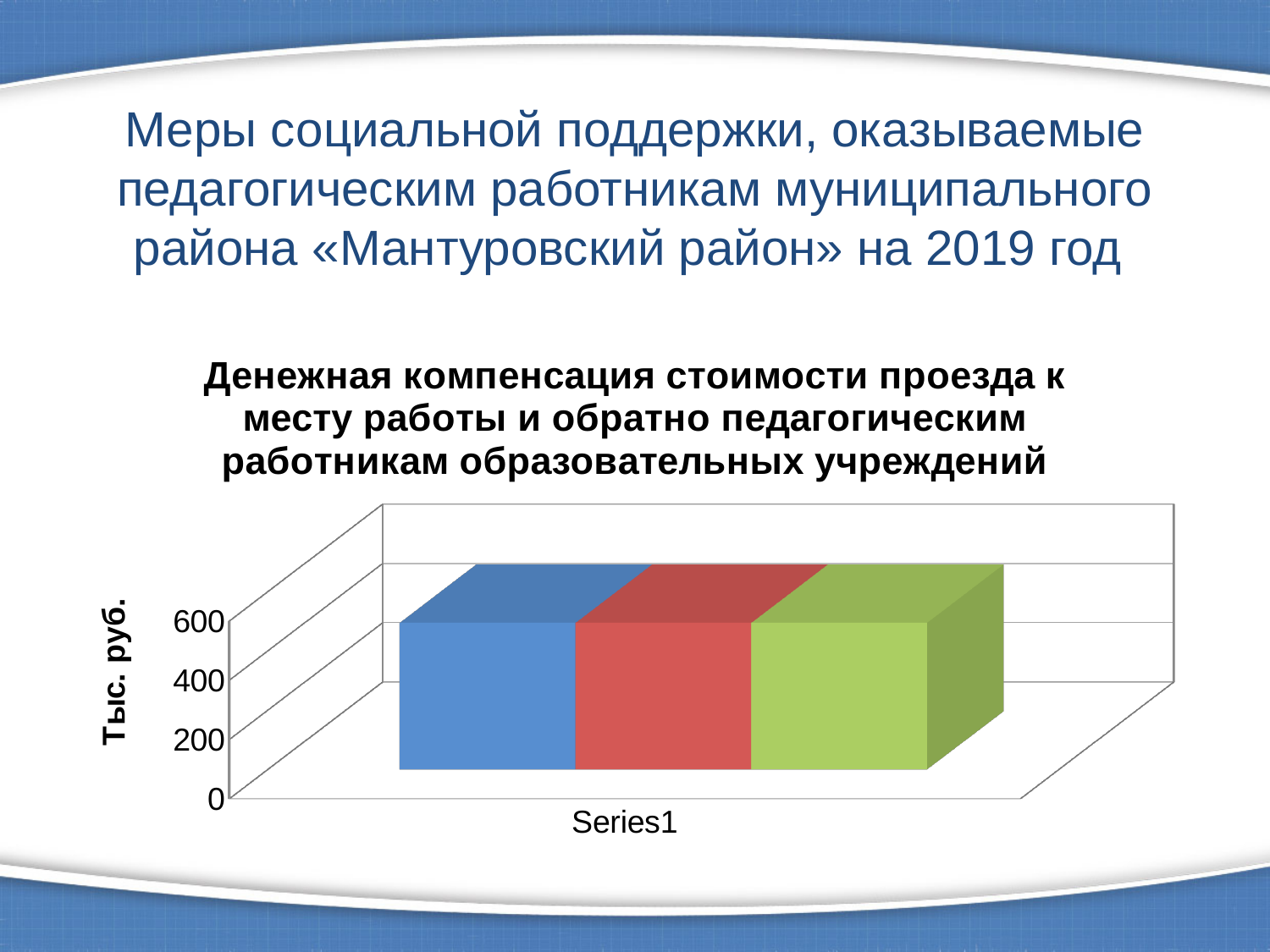
How many bars are plotted in the chart? 3 What kind of chart is shown on the slide? bar chart Is the value of the red bar greater or less than 400? greater What is the label on the vertical axis of the chart? Тыс. руб. Is the value of the green bar greater or less than 200? greater What category label appears under the bars on the horizontal axis? Series1 Is the value of the blue bar greater or less than 400? greater What is the highest tick value shown on the vertical axis? 600 What is the title of the chart? Денежная компенсация стоимости проезда к месту работы и обратно педагогическим работникам образовательных учреждений